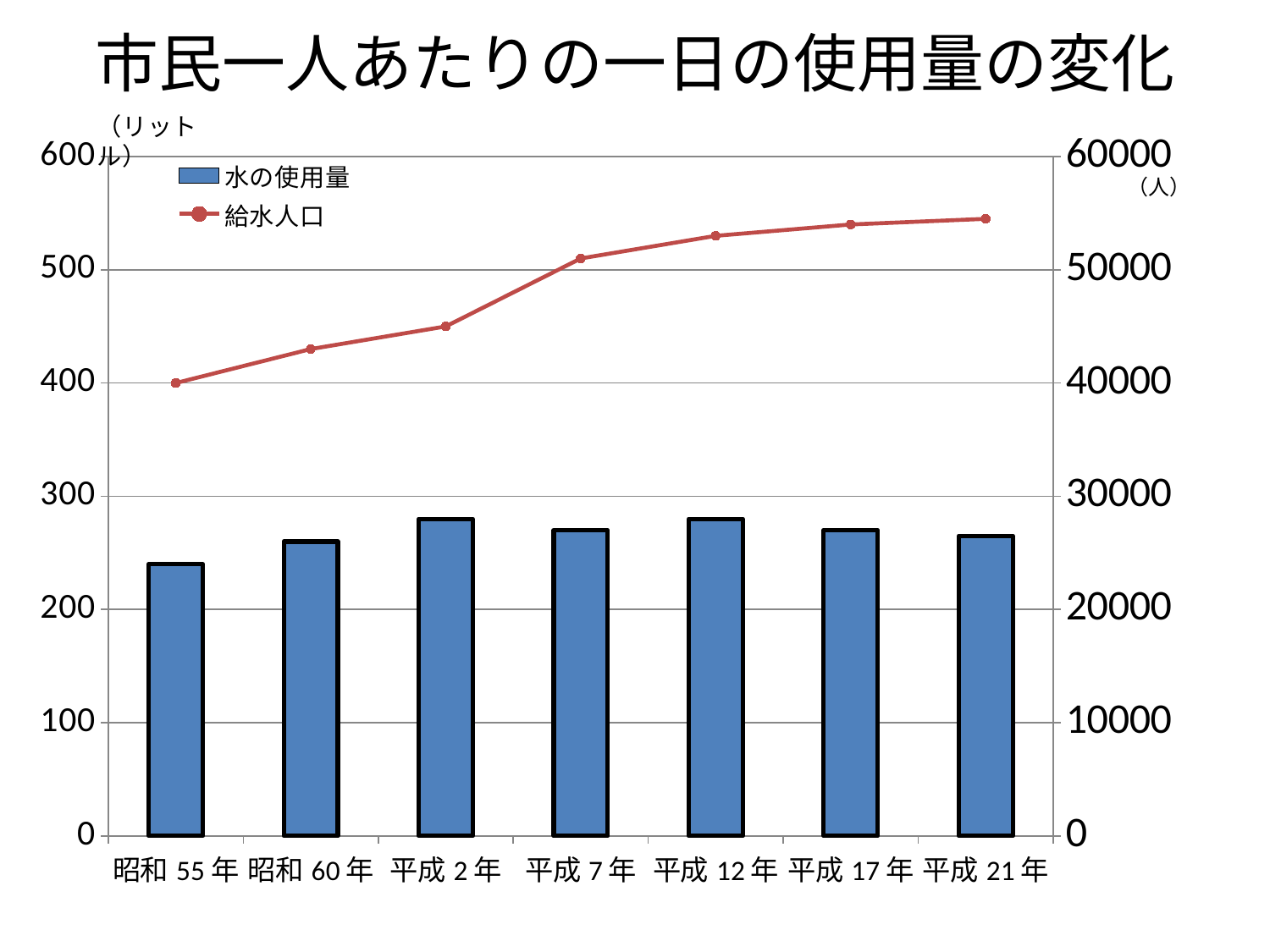
What is the title of the chart? 市民一人あたりの一日の使用量の変化 Is the 水の使用量 bar for 昭和55年 greater or less than 300? less Which series is drawn as a line with markers? 給水人口 Which year has the larger 水の使用量 bar, 昭和55年 or 昭和60年? 昭和60年 How many years (categories) are shown on the x axis? 7 How many series does the legend list? 2 Is the 水の使用量 bar for 平成2年 greater or less than 200? greater Which year has the lowest bar for 水の使用量? 昭和55年 What kind of chart is shown on the slide? A combination bar and line chart Which year has the lowest value for 給水人口? 昭和55年 Does the 給水人口 line rise or fall from 昭和55年 to 平成21年? rise Is the 給水人口 value for 平成7年 greater or less than 50000? greater